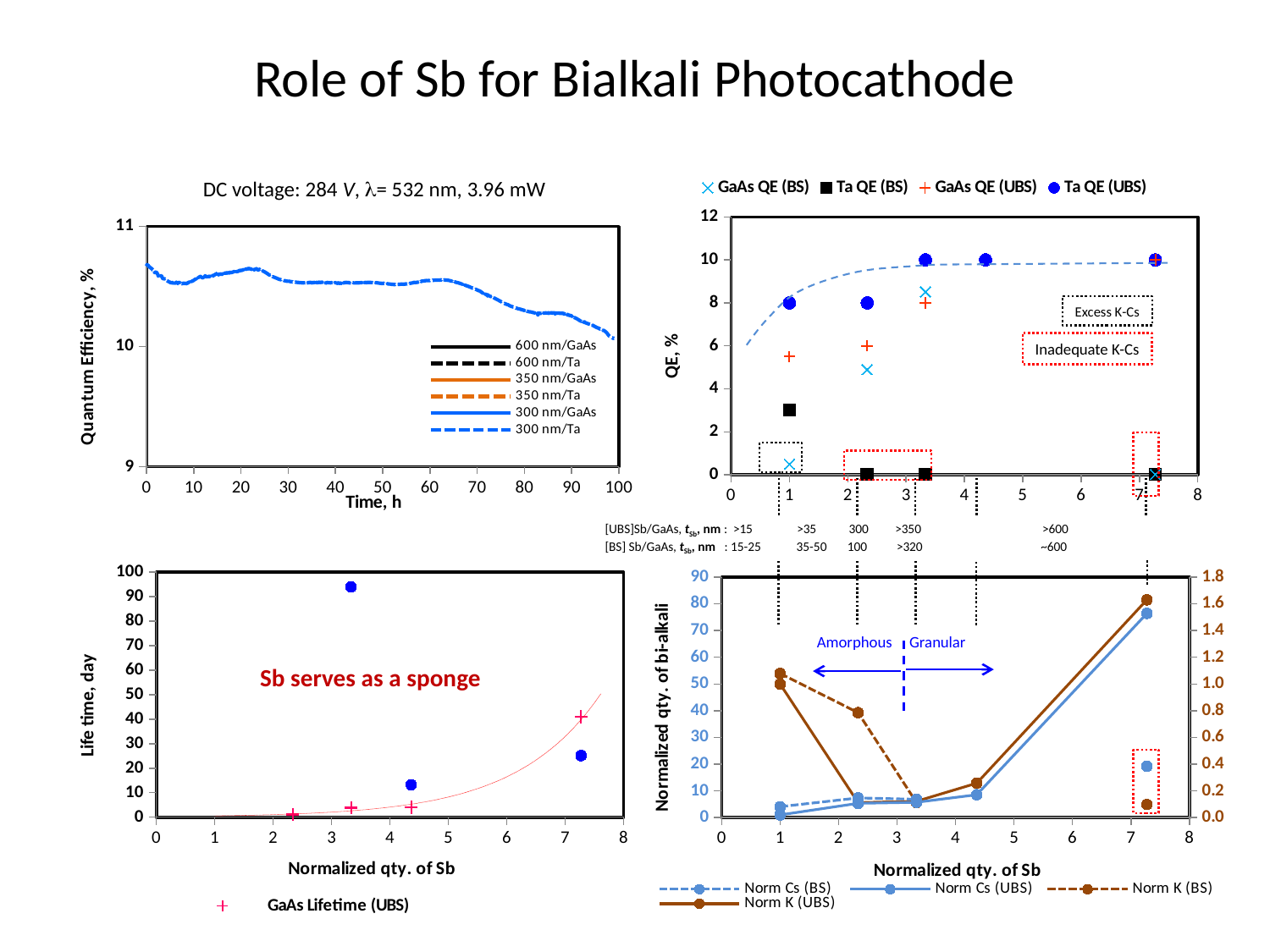
In the bottom-left chart, is the GaAs Lifetime (UBS) value at a normalized Sb quantity of about 7.3 greater or less than 30? greater In the top-right chart, which series has the highest QE at a normalized Sb quantity of about 1? Ta QE (UBS) In the top-right chart, is the Ta QE (UBS) value at a normalized Sb quantity of about 1 greater or less than 6? greater How many series does the legend of the top-right chart (QE, % vs normalized qty. of Sb) list? 4 How many series does the legend of the top-left chart (Quantum Efficiency vs Time) list? 6 In the bottom-left chart (Life time, day vs Normalized qty. of Sb), is the highest plotted life time greater or less than 90 days? greater What text annotation is written inside the bottom-left chart? Sb serves as a sponge How many series does the legend of the bottom-right chart (Normalized qty. of bi-alkali) list? 4 In the top-left chart, what is the label of the x axis? Time, h In the bottom-right chart, does the Norm Cs (UBS) series rise or fall between a normalized Sb quantity of about 4.3 and about 7.3? rise What kind of chart is the top-left chart titled 'DC voltage: 284 V, λ= 532 nm, 3.96 mW'? line chart